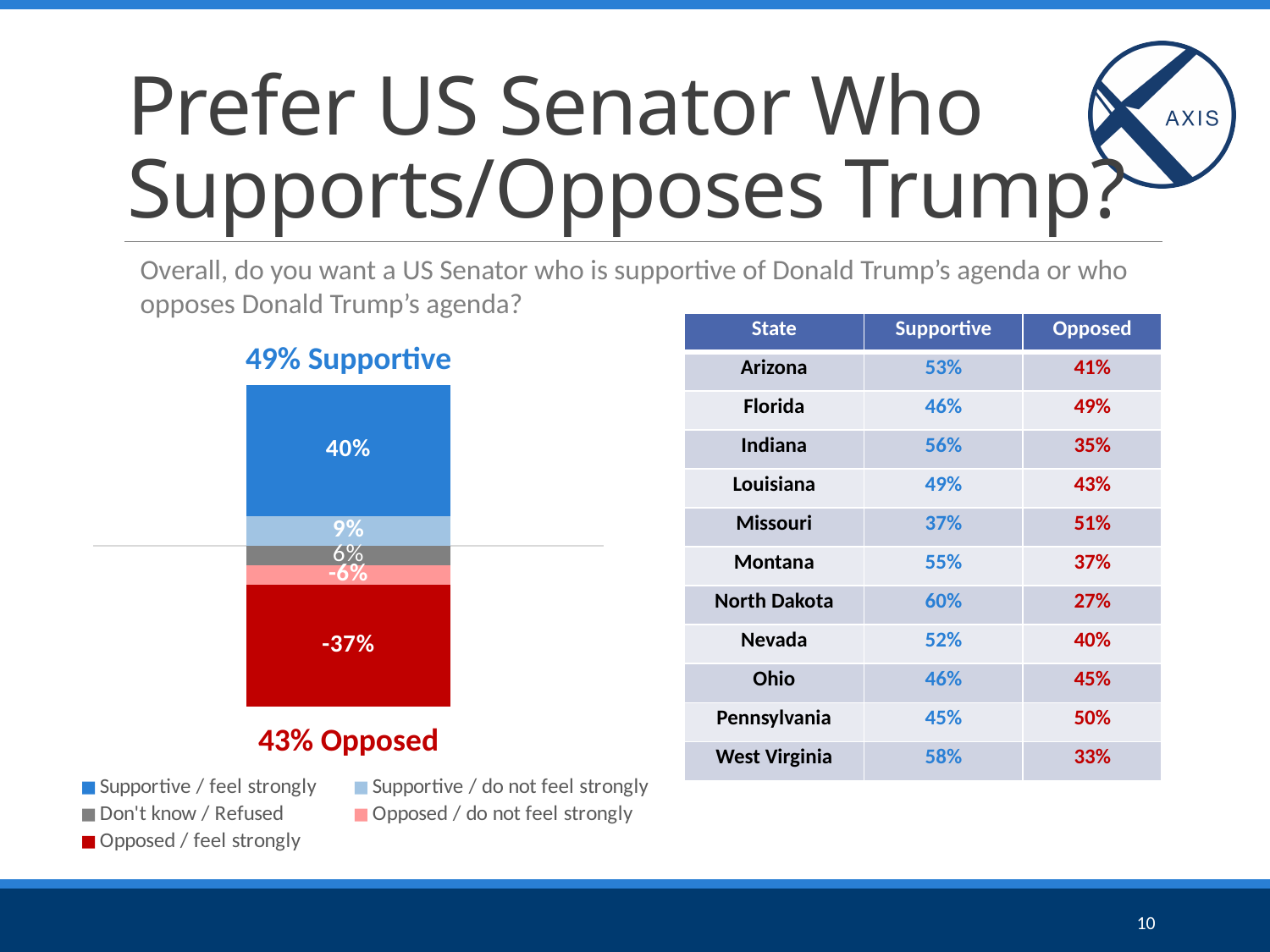
What type of chart is shown on the slide? bar chart What is the value for the 'Supportive / feel strongly' segment of the bar? 40% What is the value for the 'Don't know / Refused' segment of the bar? 6% What is the value for the 'Opposed / feel strongly' segment of the bar? -37% What is the difference between the 'Supportive / feel strongly' segment (40%) and the 'Supportive / do not feel strongly' segment (9%)? 31% What is the value for the 'Opposed / do not feel strongly' segment of the bar? -6% Which colour represents 'Opposed / feel strongly' in the chart? dark red Which segment of the bar has the largest value? Supportive / feel strongly What is the value for the 'Supportive / do not feel strongly' segment of the bar? 9% What is the total opposed share shown below the bar? 43% Opposed How many series does the chart legend list? 5 What is the total supportive share shown above the bar? 49% Supportive